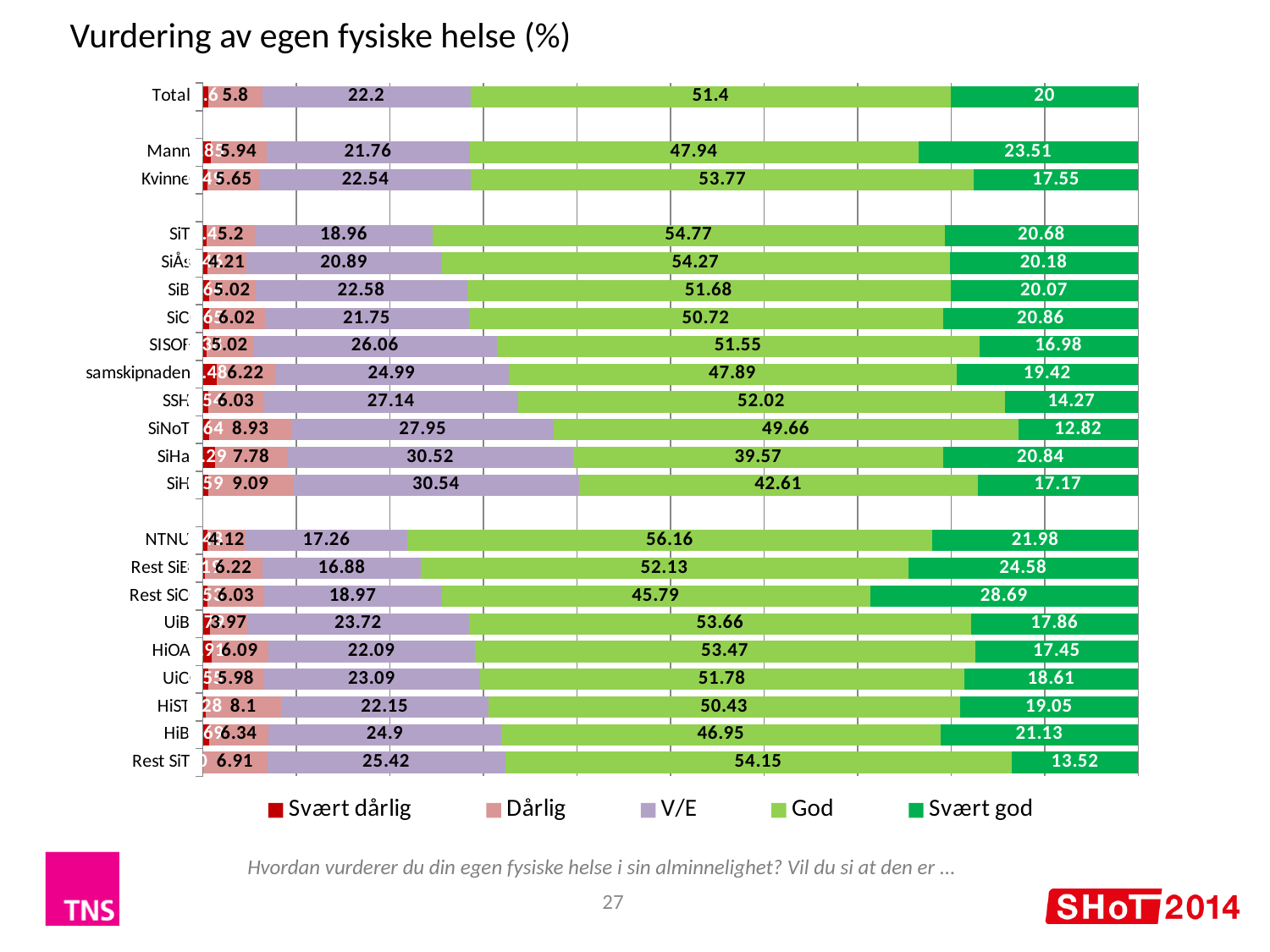
What is the value of the God segment for Total? 51.4 What is the V/E value for SiHa? 30.52 Which category has the lowest Svært god value? SiNoT Which category has the lowest God value? SiHa What is the Svært god value for Rest SiT? 13.52 How many series does the legend list? 5 What is the difference between the Svært god values for Mann and Kvinne? 5.96 Which has a larger God value, Mann or Kvinne? Kvinne What kind of chart is shown on the slide? Stacked bar chart What is the Dårlig value for SiNoT? 8.93 What is the title of the chart? Vurdering av egen fysiske helse (%) What is the Svært god value for Mann? 23.51